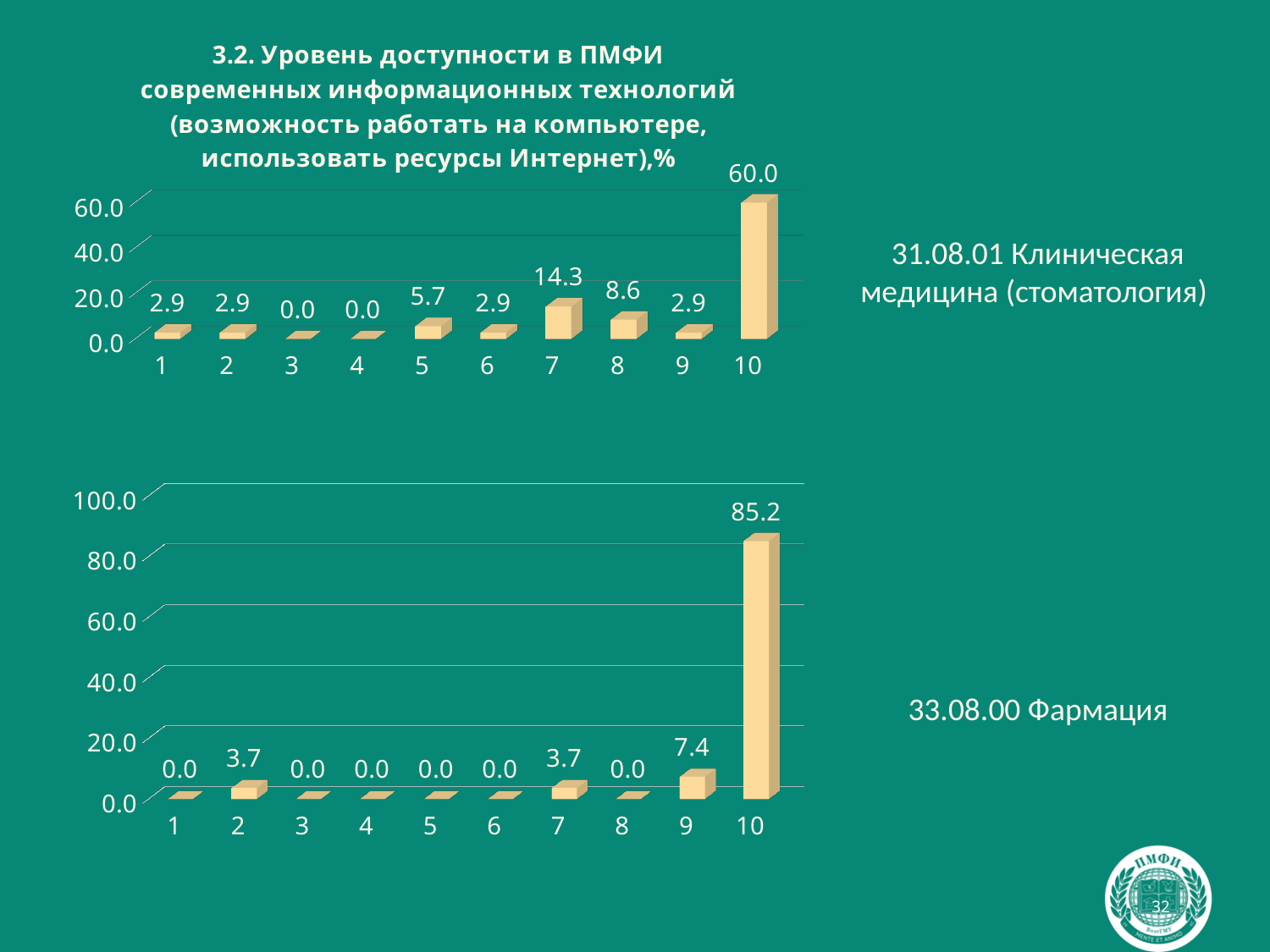
In the bottom chart (33.08.00 Фармация), is the value for category 10 greater or less than 80.0? greater In the top chart (31.08.01 Клиническая медицина (стоматология)), what is the difference between the values for category 10 and category 7? 45.7 What kind of chart is the bottom chart (33.08.00 Фармация)? bar chart In the bottom chart (33.08.00 Фармация), how many categories have a value of 0.0? 6 In the top chart (31.08.01 Клиническая медицина (стоматология)), what is the value for category 10? 60.0 What is the highest tick value on the vertical axis of the bottom chart (33.08.00 Фармация)? 100.0 In the bottom chart (33.08.00 Фармация), which category has the highest value? 10 In the bottom chart (33.08.00 Фармация), what is the value for category 9? 7.4 How many categories are shown on the x axis of the top chart (31.08.01 Клиническая медицина (стоматология))? 10 In the top chart (31.08.01 Клиническая медицина (стоматология)), what is the value for category 7? 14.3 In the top chart (31.08.01 Клиническая медицина (стоматология)), which is larger, the value for category 8 or category 5? category 8 In the bottom chart (33.08.00 Фармация), what is the difference between the values for category 9 and category 2? 3.7